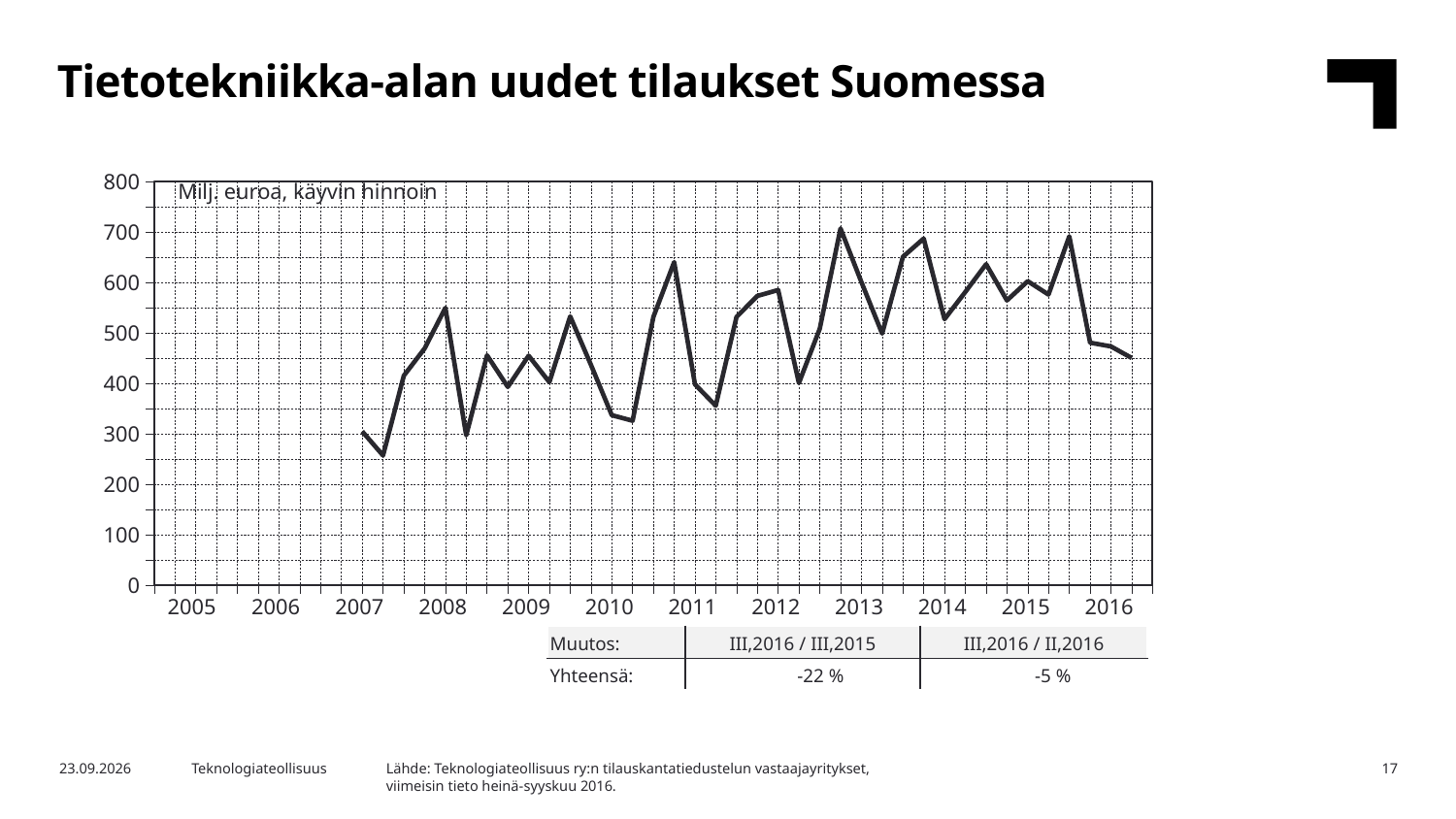
Is the lowest point of the line, in 2007, greater or less than 300? less Do the values rise or fall from the end of 2015 to the end of 2016? fall According to the table below the chart, what is the change for III,2016 / III,2015? -22 % What unit is stated inside the chart area? Milj. euroa, käyvin hinnoin What kind of chart is shown on the slide? line chart According to the table below the chart, what is the change for III,2016 / II,2016? -5 % Is the last plotted value in 2016 greater or less than 500? less In which year does the line reach its lowest point? 2007 What is the highest value shown on the y axis? 800 How many years are labelled on the x axis? 12 What is the title of the chart? Tietotekniikka-alan uudet tilaukset Suomessa